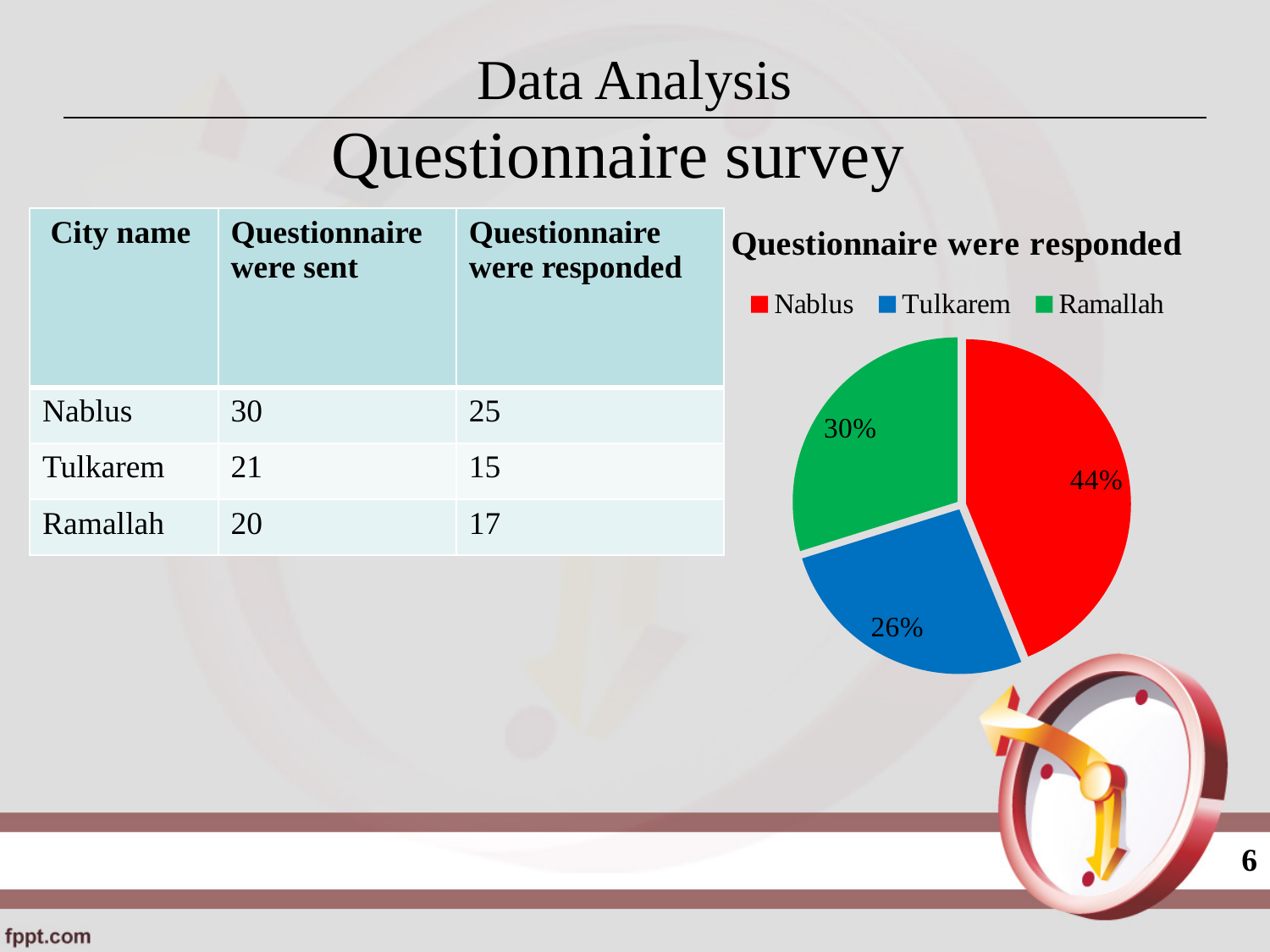
Which city has the largest slice of the pie? Nablus How many entries does the legend list? 3 How many slices does the pie chart have? 3 What share of the pie does Tulkarem have? 26% Which slice is larger, Ramallah or Tulkarem? Ramallah What is the title of the chart? Questionnaire were responded What share of the pie does Nablus have? 44% What is the difference in percentage points between the Nablus slice and the Tulkarem slice? 18 Which city has the smallest slice of the pie? Tulkarem What kind of chart is shown on the slide? pie chart What share of the pie does Ramallah have? 30% What colour is the Ramallah slice in the pie chart? green